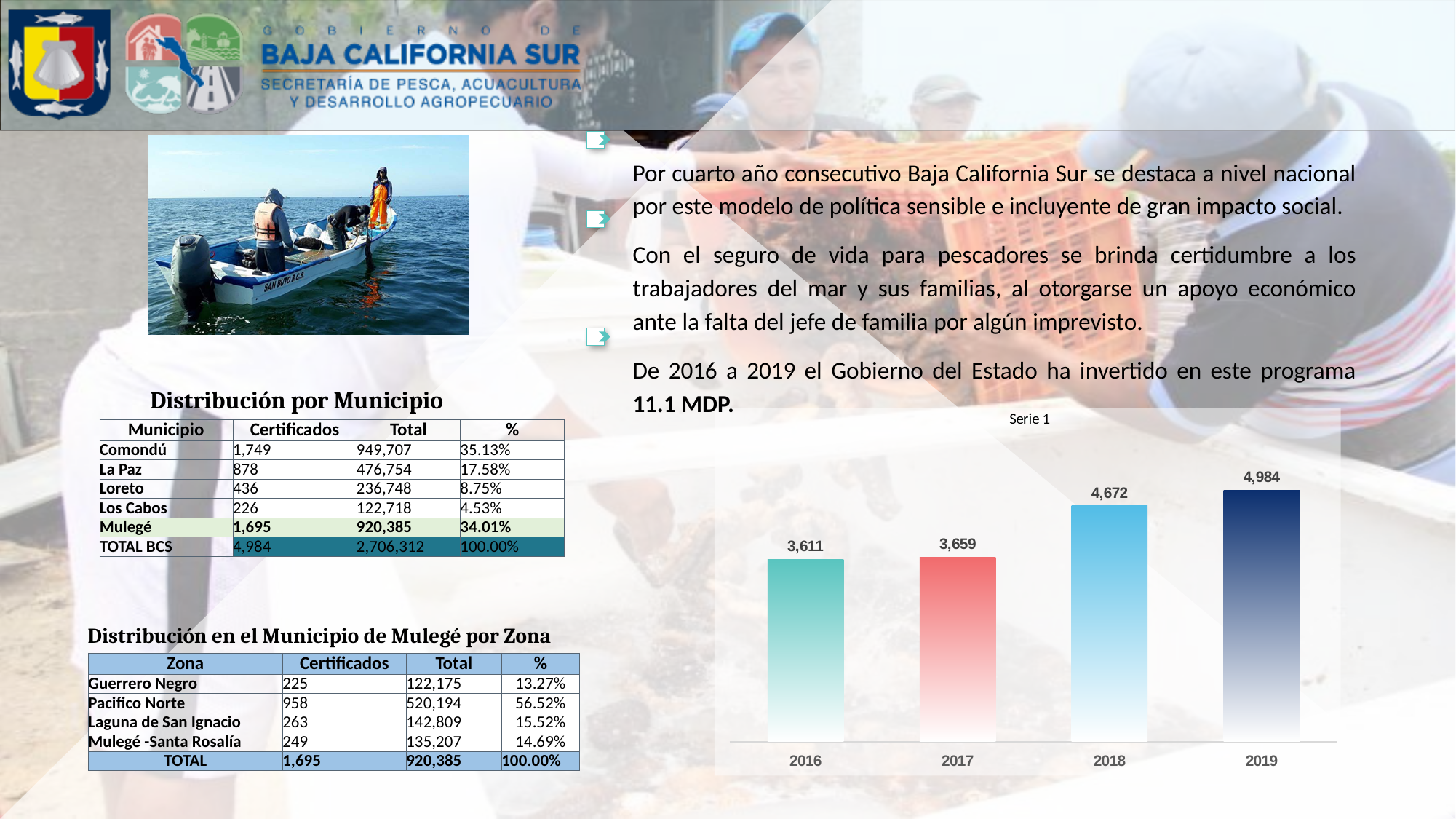
What is the value for 2018 in the bar chart? 4,672 Do the values in the bar chart rise or fall from 2016 to 2019? Rise What kind of chart is shown on the slide? Bar chart How many years are shown in the bar chart? 4 What is the difference between the values for 2018 and 2017 in the bar chart? 1,013 What is the value for 2019 in the bar chart? 4,984 Which year has the highest value in the bar chart? 2019 Which is larger in the bar chart, the value for 2018 or the value for 2019? 2019 Which year has the lowest value in the bar chart? 2016 What is the value for 2017 in the bar chart? 3,659 What is the difference between the values for 2019 and 2016 in the bar chart? 1,373 What is the value for 2016 in the bar chart? 3,611